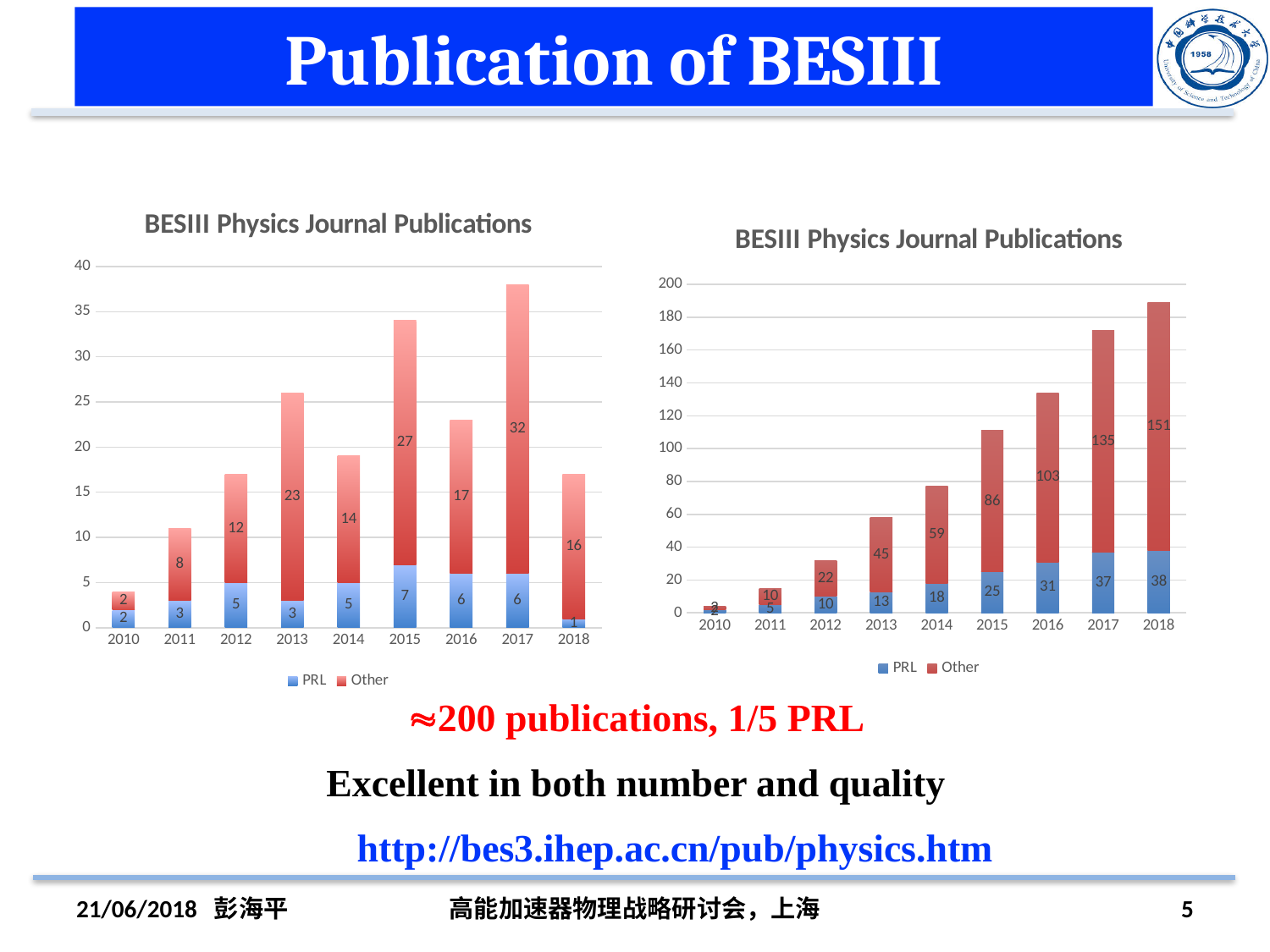
How many years are shown on the x axis of the right chart? 9 How many series does the legend of the left chart list? 2 In the left chart, what is the Other value for 2017? 32 In the left chart, is the Other value for 2015 larger than the Other value for 2016? Yes, 2015 (27) is larger than 2016 (17) In the left chart, what is the PRL value for 2015? 7 In the right chart, what is the PRL value for 2016? 31 In the right chart, what is the difference between the Other values for 2018 and 2017? 16 In the left chart, which year has the highest Other value? 2017 In the right chart, what is the Other value for 2018? 151 In the left chart, what is the total of the stacked bar for 2017? 38 In the right chart, what is the total of the stacked bar for 2018? 189 In the left chart, which year has the lowest PRL value? 2018